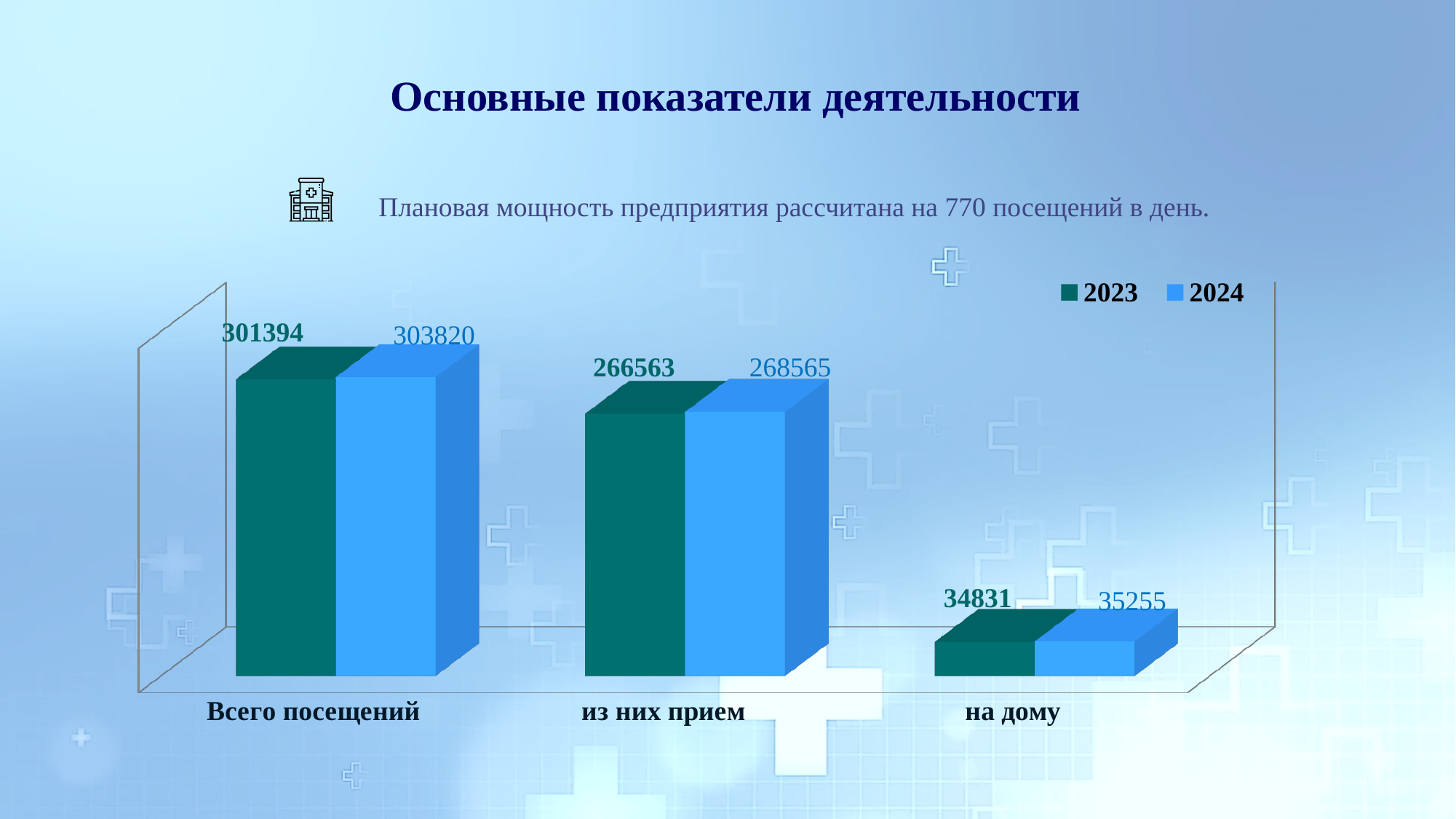
How many categories are shown on the x axis of the chart? 3 What type of chart is shown on the slide? Bar chart What is the difference between the 2024 and 2023 values for "Всего посещений"? 2426 How many series does the legend list? 2 What is the value for 2024 in the "Всего посещений" category? 303820 What is the value for 2023 in the "Всего посещений" category? 301394 What is the value for 2024 in the "на дому" category? 35255 Which category has the lowest values in the chart? на дому Which category has the highest values in the chart? Всего посещений For "из них прием", which year has the larger value, 2023 or 2024? 2024 What is the value for 2023 in the "из них прием" category? 266563 What is the difference between the 2024 and 2023 values for "на дому"? 424